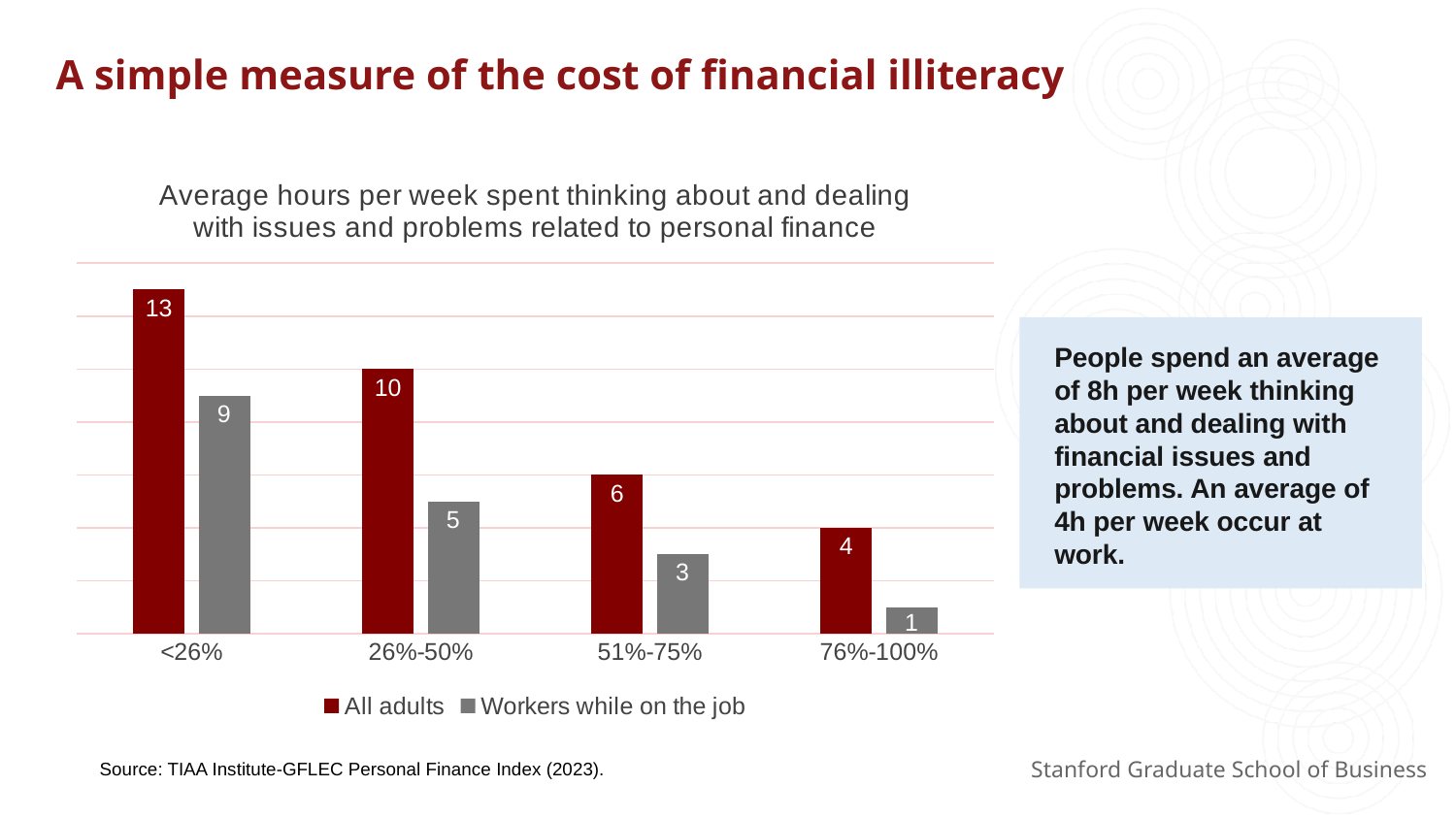
Do the values for All adults rise or fall from left to right along the x axis? Fall What is the title of the chart? Average hours per week spent thinking about and dealing with issues and problems related to personal finance What kind of chart is shown on the slide? Bar chart Which is larger: All adults in the 51%-75% category or Workers while on the job in the 26%-50% category? All adults in the 51%-75% category How many series does the legend list? 2 What is the value for Workers while on the job in the 51%-75% category? 3 What is the value for Workers while on the job in the 26%-50% category? 5 What is the difference between All adults and Workers while on the job in the <26% category? 4 What is the value for All adults in the <26% category? 13 How many categories are shown on the x axis? 4 Which category has the lowest value for Workers while on the job? 76%-100% Which category has the highest value for All adults? <26%